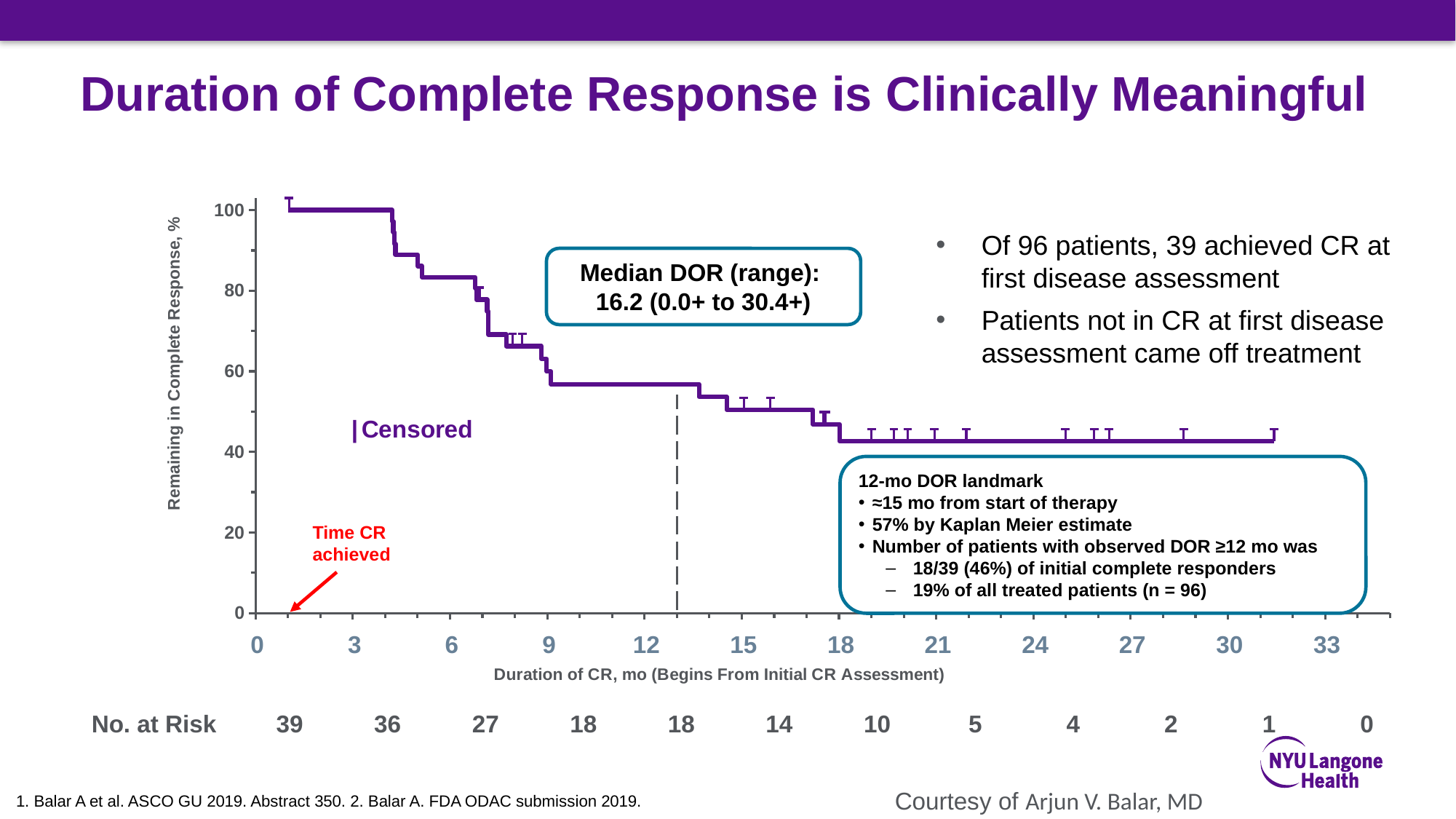
Which has a larger number at risk, 15 months or 18 months? 15 months Is the percentage remaining in complete response at 24 months greater or less than 60? less What is the difference between the number at risk at 6 months and at 9 months? 9 What is the number at risk at 33 months? 0 Is the percentage remaining in complete response at 3 months greater or less than 80? greater What is the Kaplan Meier estimate at the 12-month DOR landmark? 57% What is the number at risk at 18 months? 10 Does the curve rise or fall as duration of CR increases? fall What is the label of the x axis? Duration of CR, mo (Begins From Initial CR Assessment) What is the number at risk at 0 months? 39 What kind of chart is shown on the slide? line chart What is the number at risk at 6 months? 27